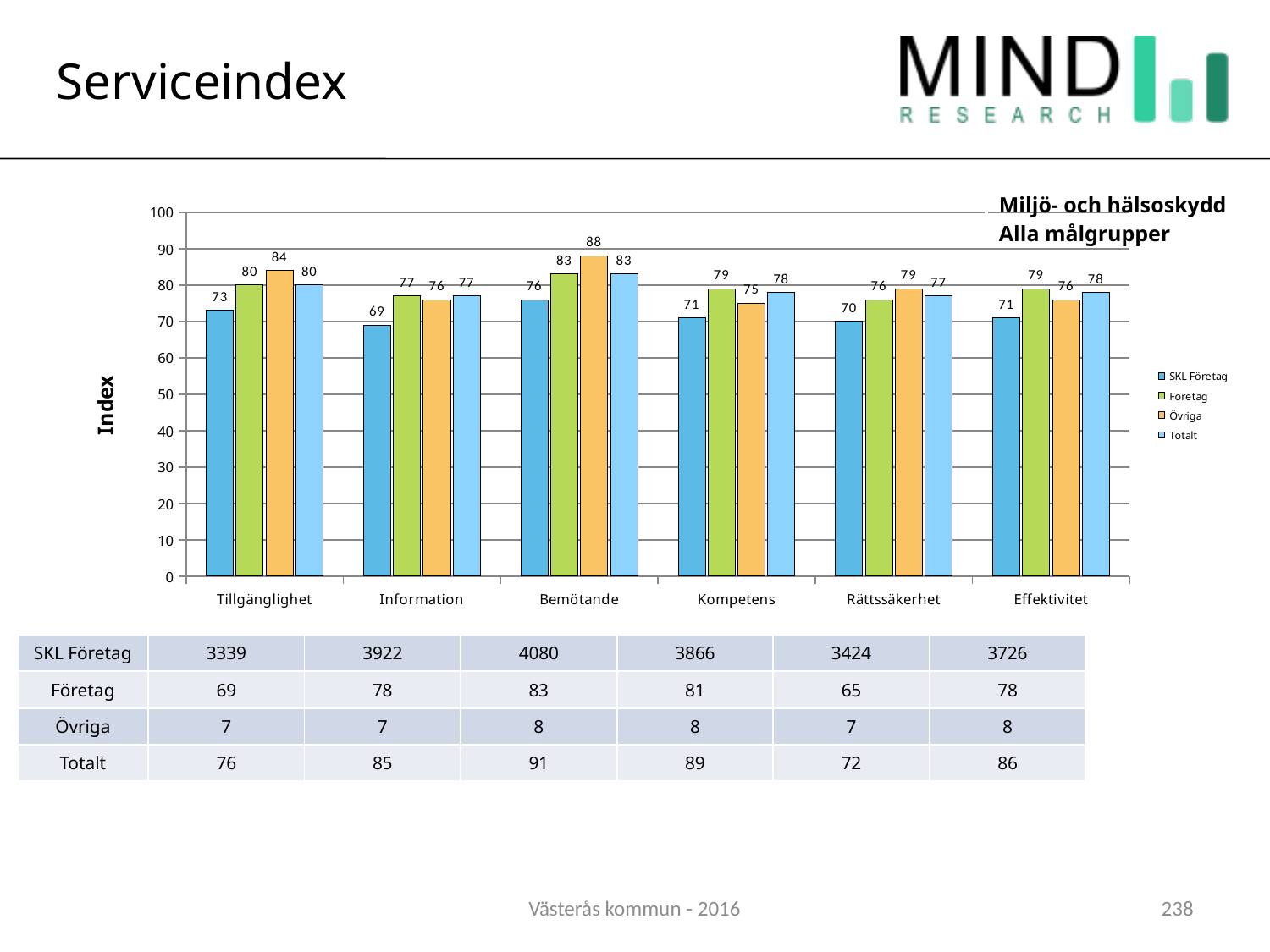
Which category has the highest Övriga value? Bemötande What is the label on the vertical axis of the chart? Index How many series does the chart legend list? 4 How many categories are shown on the x axis of the chart? 6 Which category has the lowest SKL Företag value? Information What is the Totalt value for Kompetens? 78 Which is larger for Rättssäkerhet: the Företag value or the Övriga value? Övriga What is the difference between the Övriga and SKL Företag values for Tillgänglighet? 11 What is the value for Övriga in the Bemötande category? 88 What is the value for SKL Företag in the Information category? 69 Is the SKL Företag value for Kompetens greater or less than 80? less What kind of chart is shown on the slide? bar chart